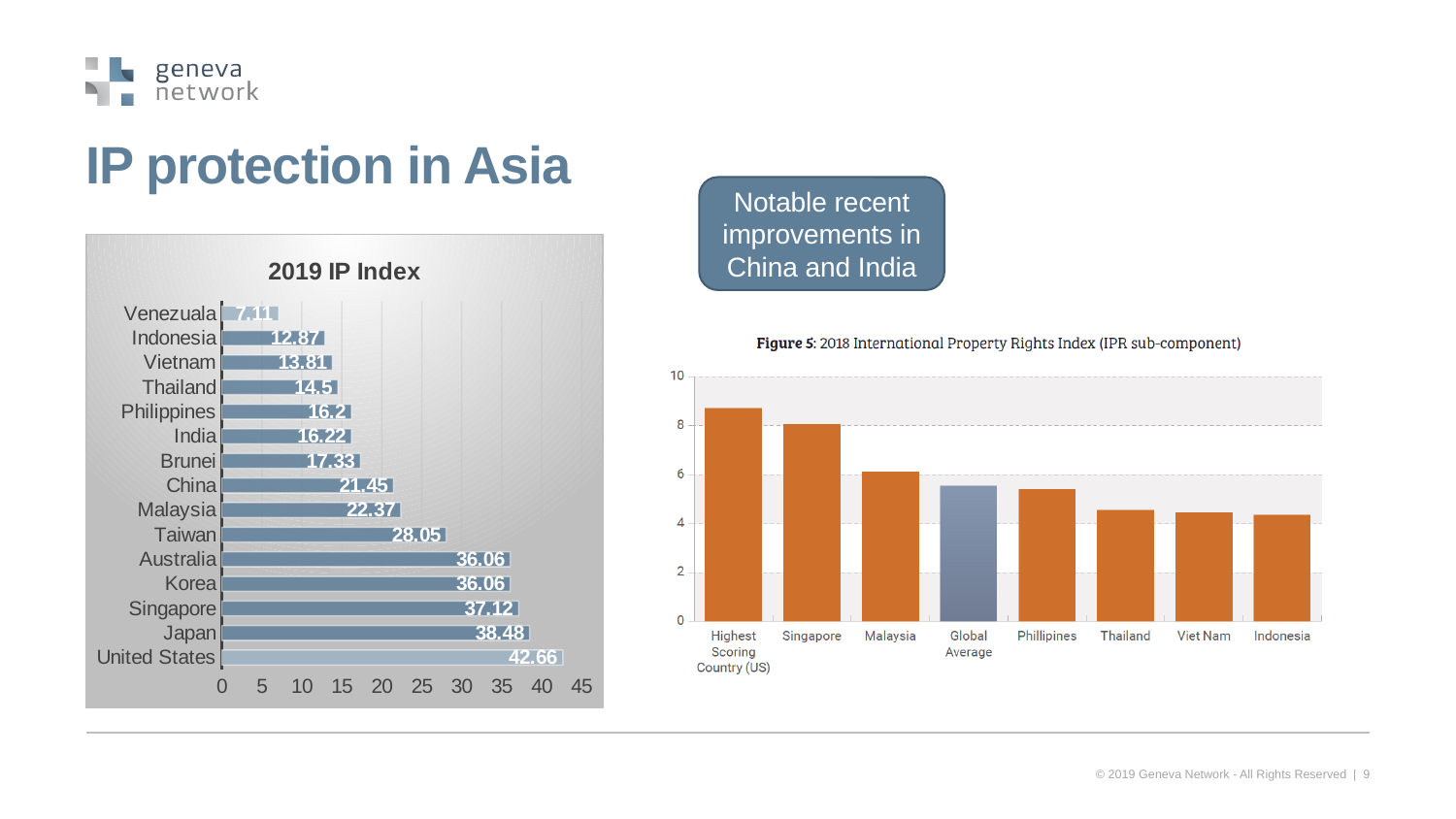
How many bars are shown in the Figure 5 chart (2018 International Property Rights Index)? 8 In the 2019 IP Index chart, what is the difference between the values for Singapore and Malaysia? 14.75 In the Figure 5 chart (2018 International Property Rights Index), which is larger, Singapore or Thailand? Singapore In the 2019 IP Index chart, what is the value for China? 21.45 What kind of chart is the 2019 IP Index chart? Bar chart In the Figure 5 chart (2018 International Property Rights Index), is the value for Malaysia greater or less than 8? less How many countries are shown in the 2019 IP Index chart? 15 In the 2019 IP Index chart, which country has the lowest value? Venezuala In the 2019 IP Index chart, which country has the highest value? United States In the 2019 IP Index chart, what is the value for Japan? 38.48 In the Figure 5 chart (2018 International Property Rights Index), which category has the highest bar? Highest Scoring Country (US) In the 2019 IP Index chart, which has the larger value, Taiwan or Brunei? Taiwan